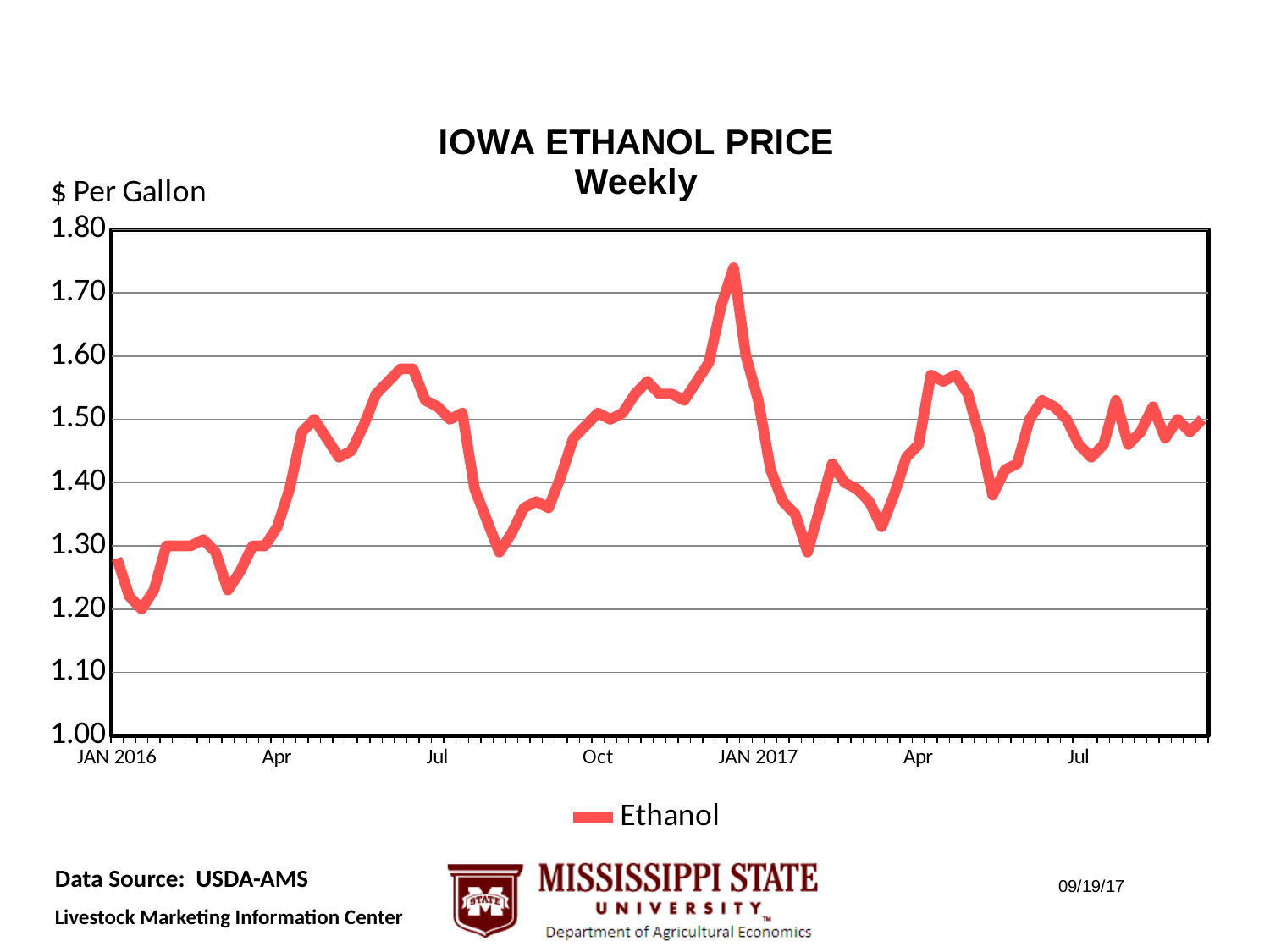
Is the Ethanol value at the Apr 2017 tick greater or less than 1.50? less Is the lowest value of the Ethanol line, reached in early 2016, greater or less than 1.30? less What is the title of the chart? IOWA ETHANOL PRICE Weekly Is the peak value of the Ethanol line near JAN 2017 greater or less than 1.70? greater Does the Ethanol line rise or fall between the Apr 2016 tick and the Jul 2016 tick? rise What unit is the vertical axis labelled in? $ Per Gallon Does the Ethanol line rise or fall immediately after its peak near JAN 2017? fall What kind of chart is shown on the slide? line chart Near which x-axis label does the Ethanol line reach its highest value? JAN 2017 How many series does the legend list? 1